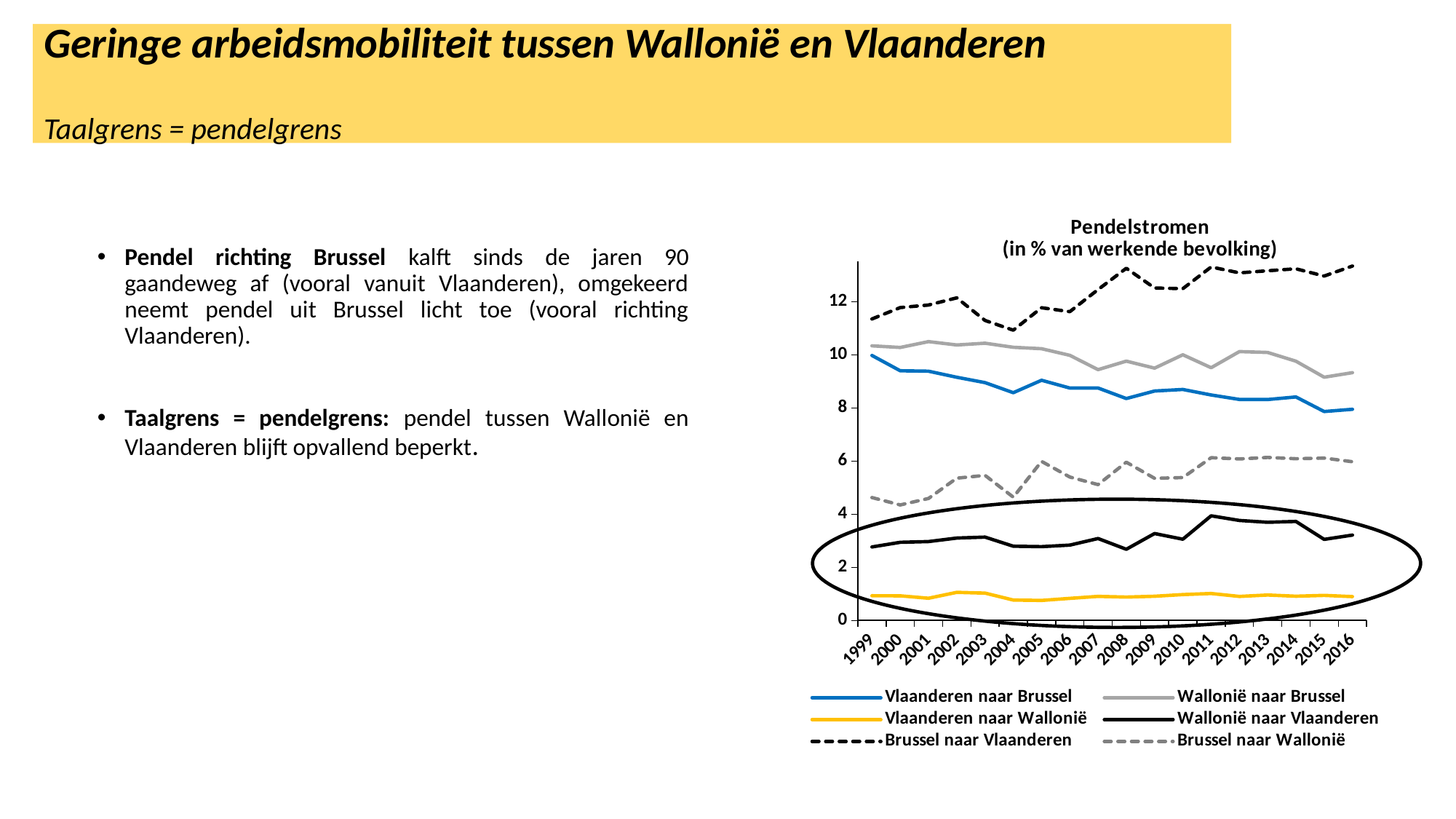
In 2016, which is larger: Wallonië naar Brussel or Vlaanderen naar Brussel? Wallonië naar Brussel Is the value for Brussel naar Vlaanderen in 2016 greater or less than 12? greater How many series does the legend of the Pendelstromen chart list? 6 Does the value for Vlaanderen naar Brussel rise or fall from 1999 to 2016? Fall Does the value for Brussel naar Vlaanderen rise or fall from 1999 to 2016? Rise Is the value for Wallonië naar Vlaanderen in 1999 greater or less than 4? less What kind of chart is shown on the slide? Line chart What is the title of the chart? Pendelstromen (in % van werkende bevolking) How many years are shown on the x axis of the Pendelstromen chart? 18 Which series has the highest value in 2016? Brussel naar Vlaanderen Is the value for Vlaanderen naar Wallonië in 2016 greater or less than 2? less Which series has the lowest value in 2016? Vlaanderen naar Wallonië